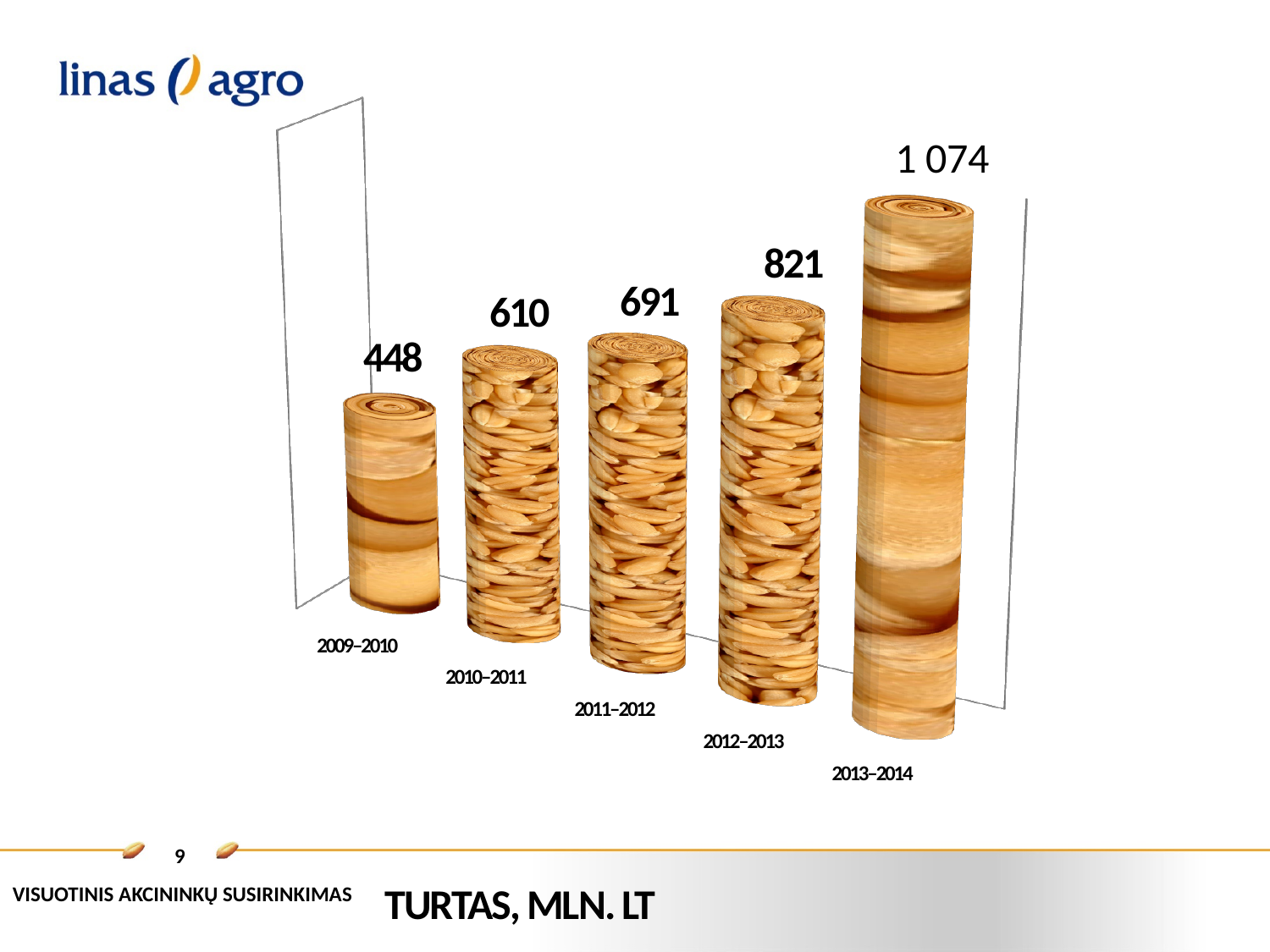
Do the values rise or fall from 2009–2010 to 2013–2014? rise Which is larger, the value for 2010–2011 or the value for 2012–2013? 2012–2013 What is the difference between the values for 2012–2013 and 2011–2012? 130 What is the title of the chart shown on the slide? TURTAS, MLN. LT What kind of chart is shown on the slide? bar chart What is the value for 2009–2010? 448 Which period has the lowest value? 2009–2010 Which period has the highest value? 2013–2014 What is the value for 2013–2014? 1 074 What is the difference between the values for 2013–2014 and 2009–2010? 626 How many periods are shown in the chart? 5 What is the value for 2011–2012? 691